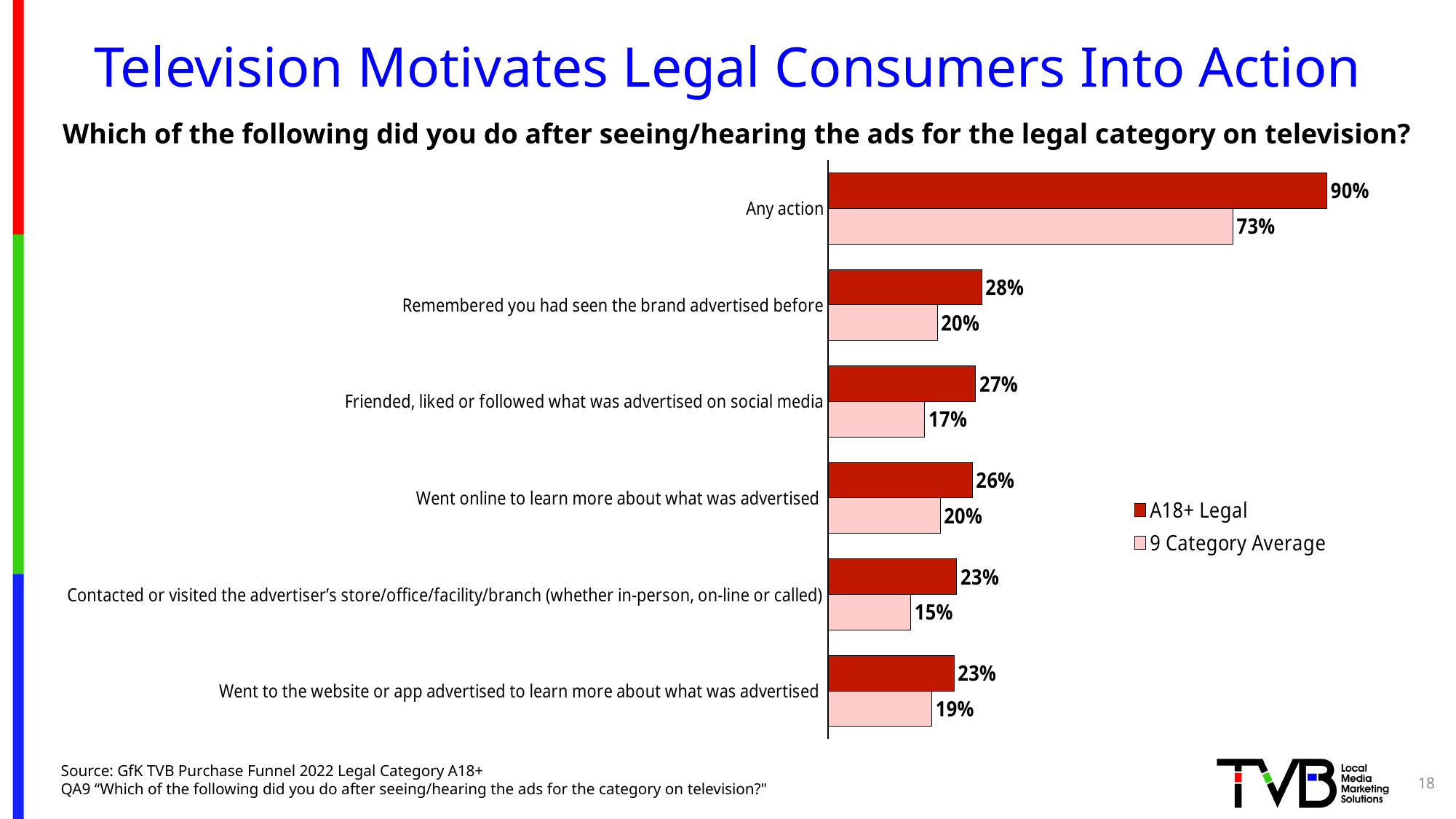
Which series is shown in dark red in the legend? A18+ Legal What is the A18+ Legal value for "Any action"? 90% How many series does the legend list? 2 Which category has the lowest 9 Category Average value? Contacted or visited the advertiser's store/office/facility/branch (whether in-person, on-line or called) What is the difference between the A18+ Legal and 9 Category Average values for "Any action"? 17% What is the 9 Category Average value for "Went online to learn more about what was advertised"? 20% Which category has the highest A18+ Legal value? Any action What is the A18+ Legal value for "Friended, liked or followed what was advertised on social media"? 27% Which is larger: the A18+ Legal value for "Remembered you had seen the brand advertised before" or the A18+ Legal value for "Went to the website or app advertised to learn more about what was advertised"? Remembered you had seen the brand advertised before What is the difference between the A18+ Legal and 9 Category Average values for "Friended, liked or followed what was advertised on social media"? 10% What kind of chart is shown on the slide? Bar chart How many categories are shown on the chart? 6